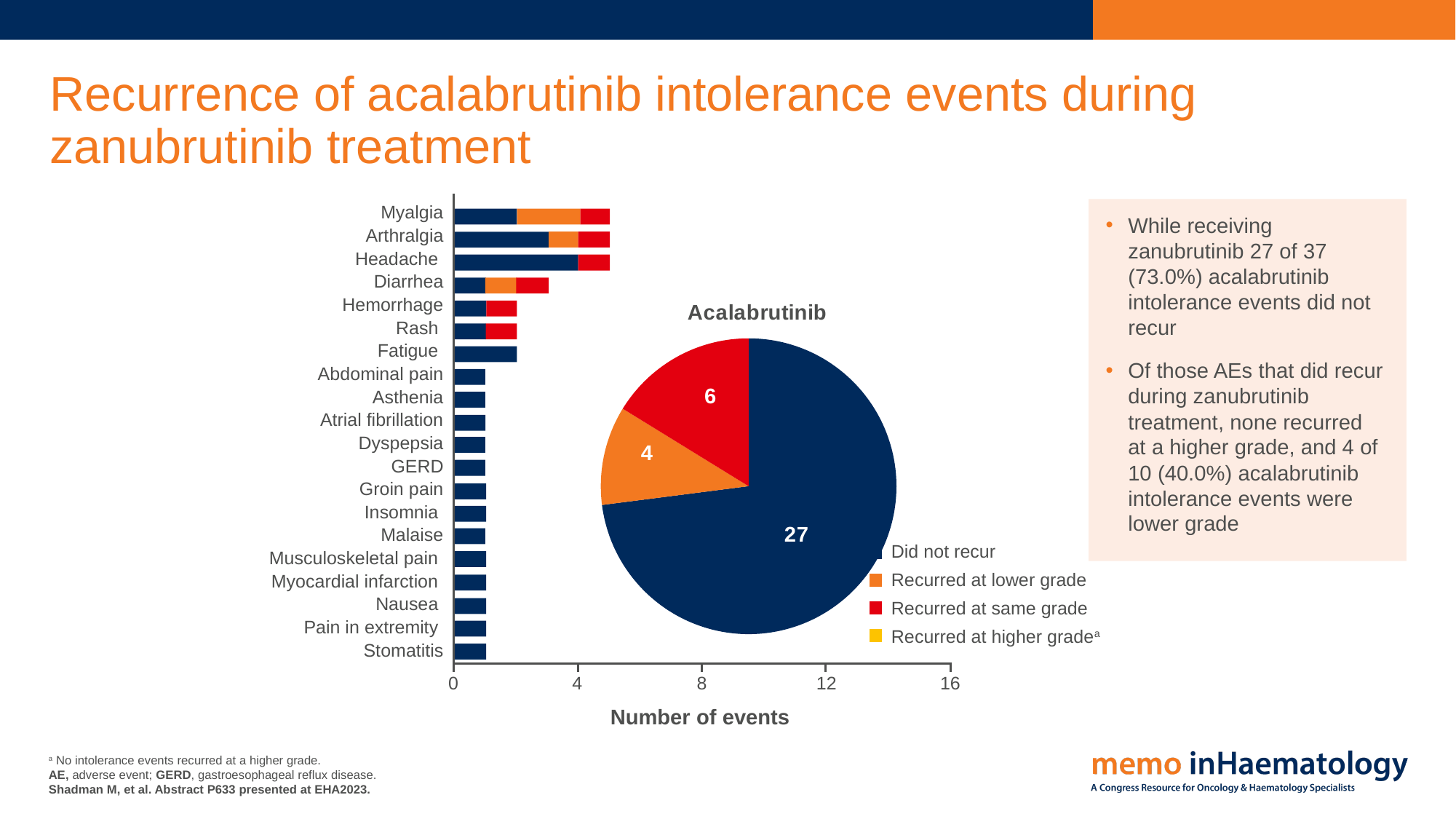
On the pie chart titled Acalabrutinib, how many events did not recur? 27 On the pie chart titled Acalabrutinib, which is larger: recurred at same grade or recurred at lower grade? Recurred at same grade On the pie chart titled Acalabrutinib, what share of all events did not recur? 73.0% On the pie chart titled Acalabrutinib, what is the difference between the number of events that did not recur and the number that recurred at the same grade? 21 On the pie chart titled Acalabrutinib, how many events recurred at the same grade? 6 On the bar chart on the left, is the total number of events for Myalgia greater or less than 4? greater On the bar chart on the left, how many adverse event categories are listed on the vertical axis? 20 On the bar chart on the left, is the number of events for Stomatitis greater or less than 4? less What kind of chart is the chart on the left showing Number of events? Bar chart On the pie chart titled Acalabrutinib, which category has the largest slice? Did not recur How many entries does the legend of the pie chart titled Acalabrutinib list? 4 On the pie chart titled Acalabrutinib, how many events recurred at a lower grade? 4